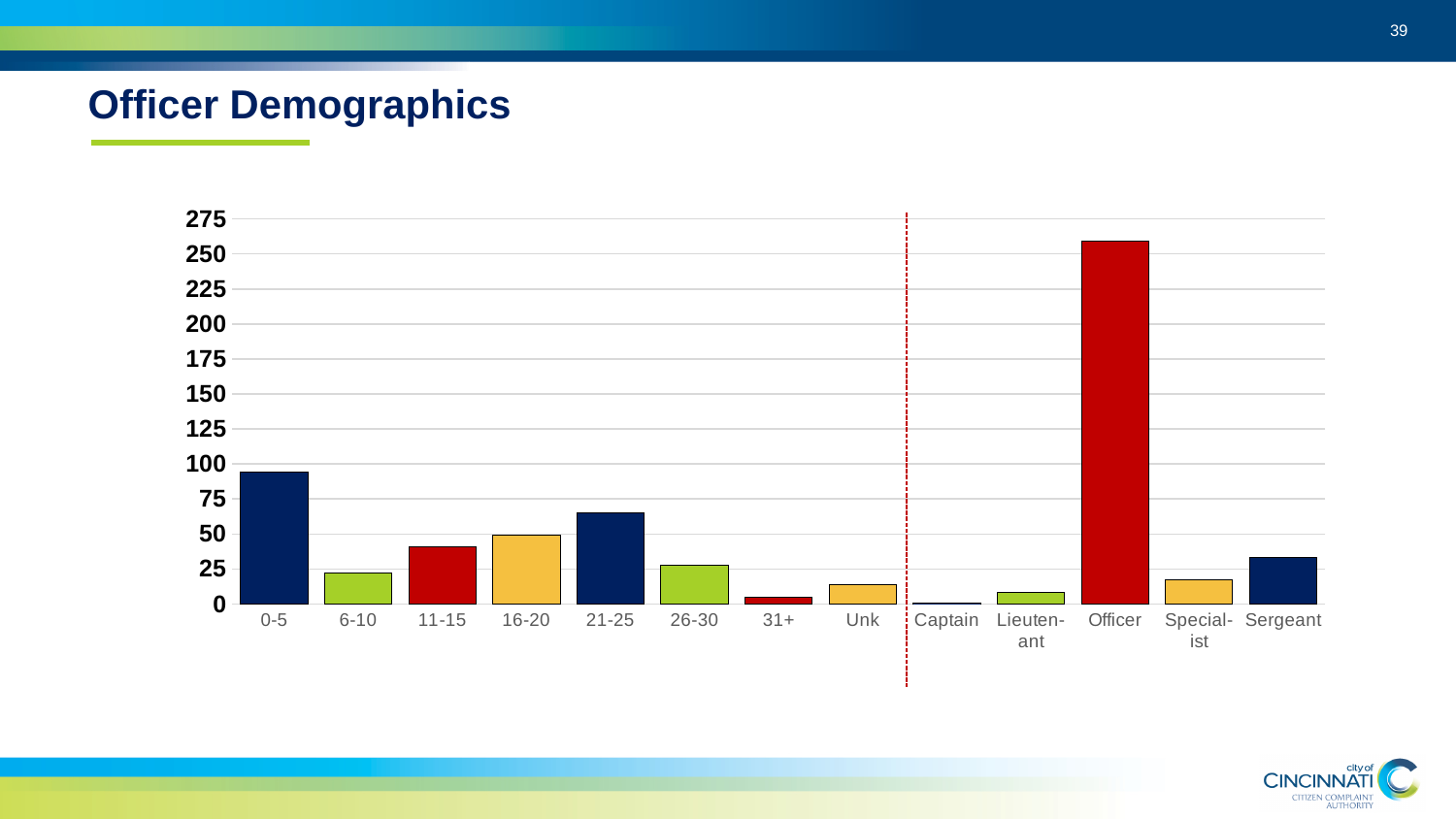
Is the value for 6-10 greater or less than 25? less What is the title of the slide containing the chart? Officer Demographics Is the value for 0-5 greater or less than 75? greater Is the value for Specialist greater or less than 25? less What kind of chart is shown on the slide? bar chart Which is larger, the value for 0-5 or the value for 21-25? 0-5 How many categories are shown along the x axis of the chart? 13 Which category has the highest bar in the chart? Officer Which is larger, the value for 16-20 or the value for 11-15? 16-20 Which category has the lowest bar in the chart? Captain